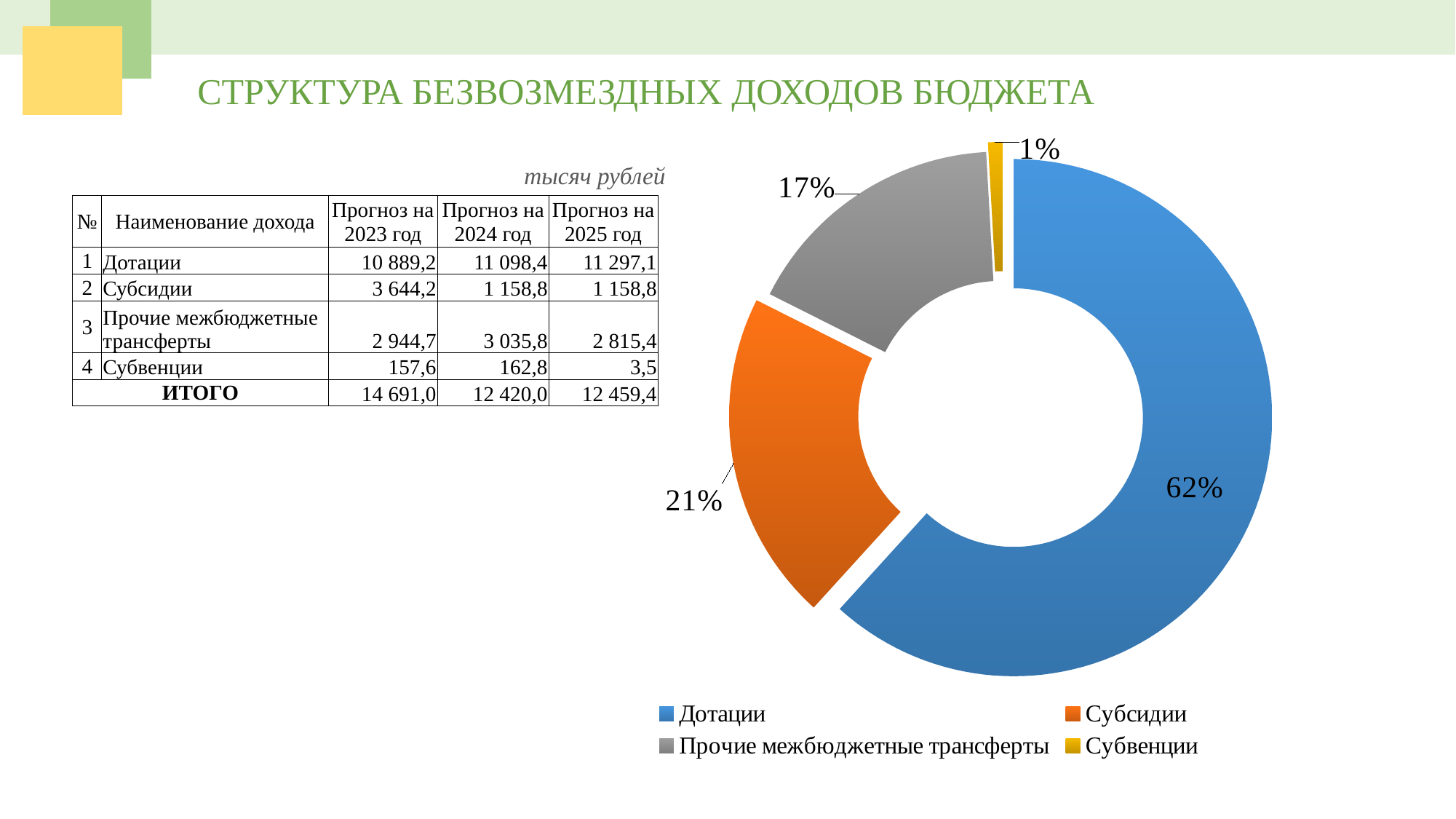
How many slices does the pie chart have? 4 Which category has the largest slice in the pie chart? Дотации What percentage is shown for Субсидии in the pie chart? 21% What type of chart is shown on the slide? Doughnut (pie) chart What colour is the Дотации slice in the pie chart? Blue What percentage is shown for Субвенции in the pie chart? 1% Which category has the smallest slice in the pie chart? Субвенции Which slice is larger in the pie chart, Субсидии or Прочие межбюджетные трансферты? Субсидии By how many percentage points does the Дотации slice exceed the Субсидии slice in the pie chart? 41 What percentage share does the Дотации slice have in the pie chart? 62% What percentage is shown for Прочие межбюджетные трансферты in the pie chart? 17% How many entries does the legend of the pie chart list? 4